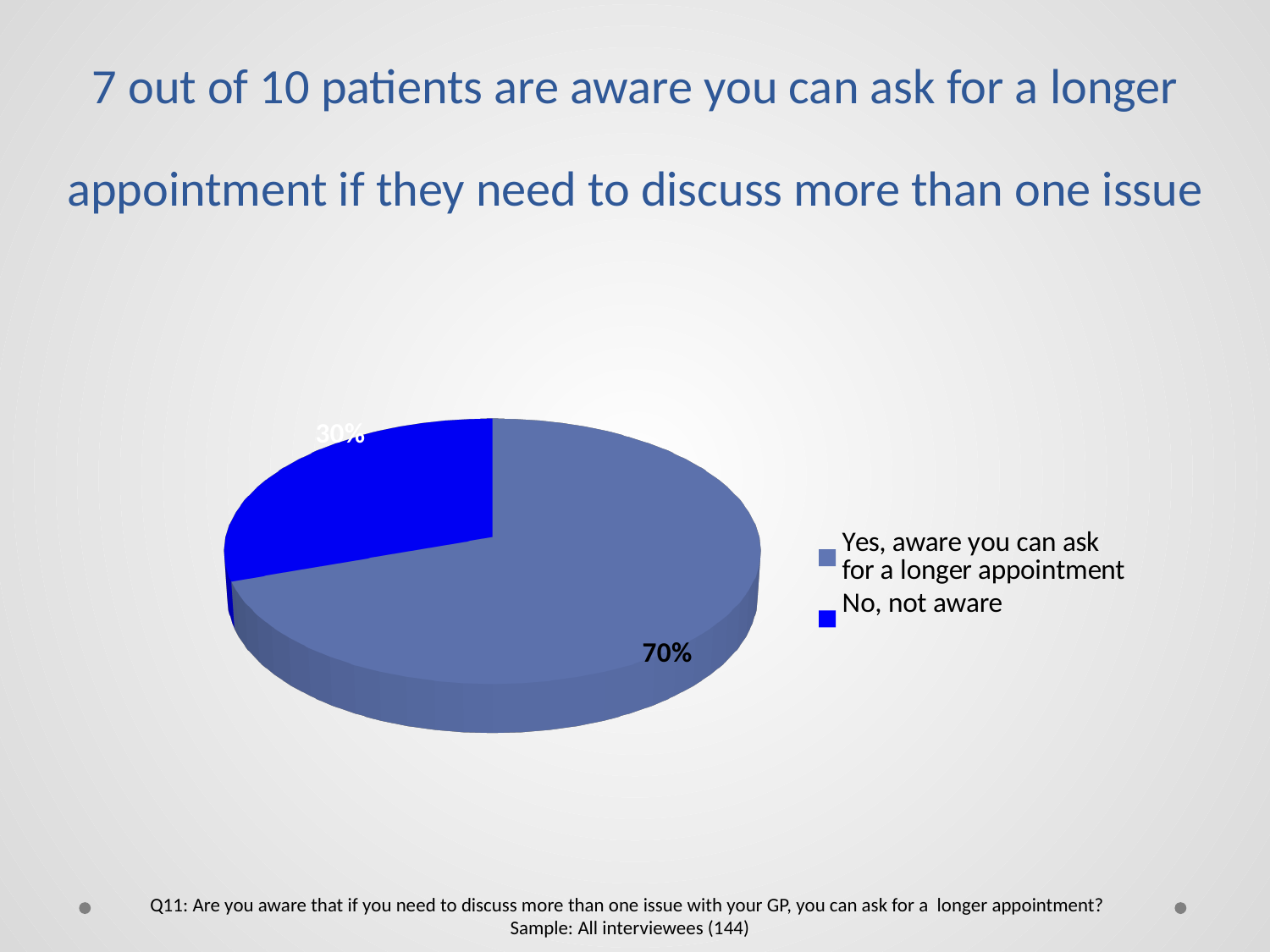
What is the sample size stated on the slide? 144 How many entries does the legend list? 2 What percentage of patients are not aware they can ask for a longer appointment? 30% What percentage of patients are aware they can ask for a longer appointment? 70% What kind of chart is shown on the slide? pie chart Which category has the smallest share of the pie? No, not aware Which category has the largest share of the pie? Yes, aware you can ask for a longer appointment Which is larger: the share of patients who are aware or the share who are not aware? Yes, aware you can ask for a longer appointment What is the difference in percentage points between the 'Yes, aware' and 'No, not aware' slices? 40 What colour is the 'No, not aware' slice? blue How many slices does the pie chart have? 2